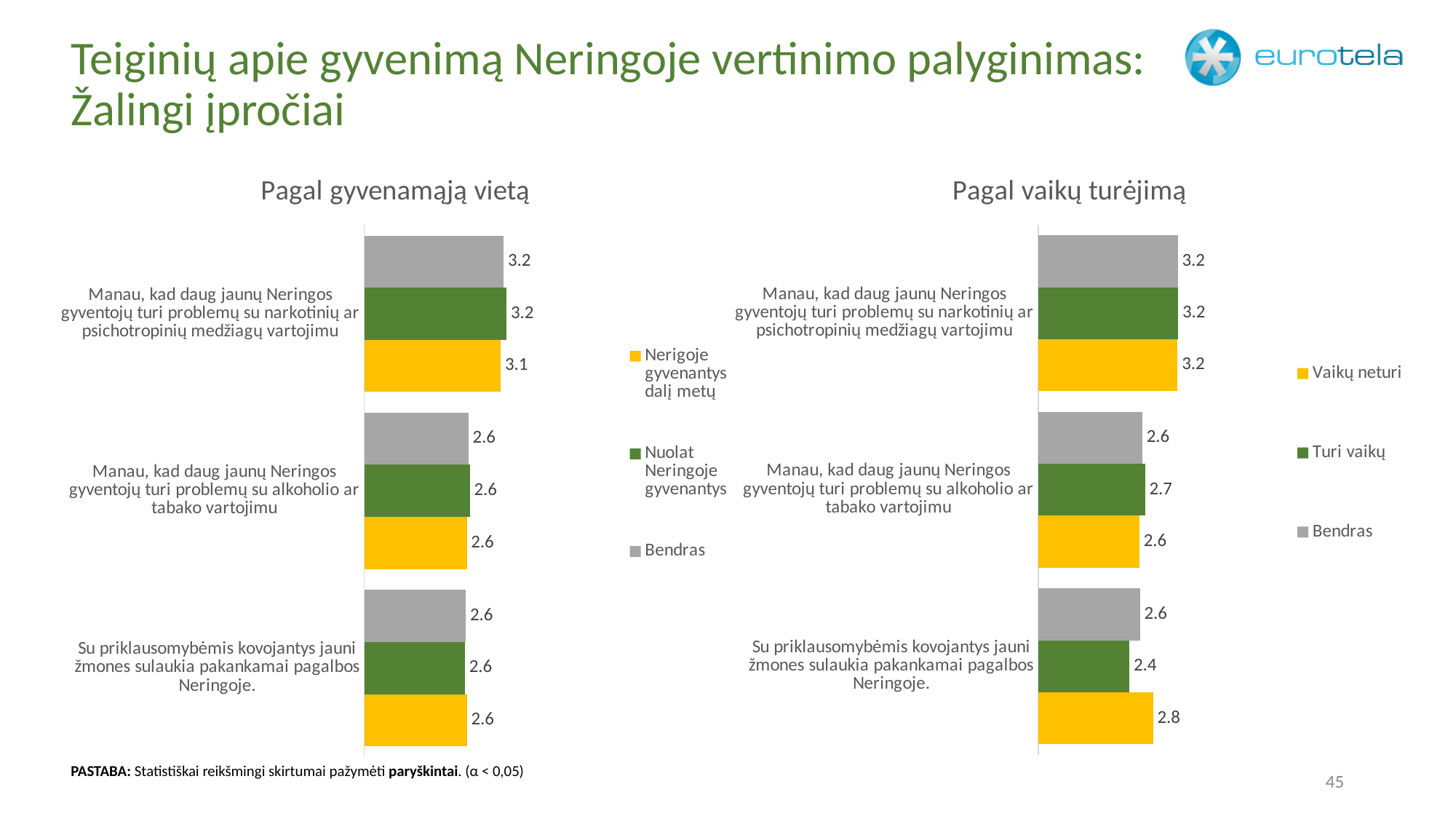
In the 'Pagal gyvenamąją vietą' chart, which is larger on the drug and psychotropic substance statement: the value for 'Nuolat Neringoje gyvenantys' or for 'Nerigoje gyvenantys dalį metų'? Nuolat Neringoje gyvenantys In the 'Pagal vaikų turėjimą' chart, what is the value for 'Turi vaikų' on the statement 'Su priklausomybėmis kovojantys jauni žmonės sulaukia pakankamai pagalbos Neringoje'? 2.4 In the 'Pagal vaikų turėjimą' chart, which series has the lowest value on the statement 'Su priklausomybėmis kovojantys jauni žmonės sulaukia pakankamai pagalbos Neringoje'? Turi vaikų In the 'Pagal vaikų turėjimą' chart, what is the value for 'Turi vaikų' on the statement about alcohol and tobacco problems (alkoholio ar tabako vartojimu)? 2.7 In the 'Pagal gyvenamąją vietą' chart, what is the value for 'Nerigoje gyvenantys dalį metų' on the statement about drug and psychotropic substance problems (narkotinių ar psichotropinių medžiagų vartojimu)? 3.1 In the 'Pagal gyvenamąją vietą' chart, what is the 'Bendras' value on the statement about alcohol and tobacco problems (alkoholio ar tabako vartojimu)? 2.6 In the 'Pagal vaikų turėjimą' chart, what is the difference between the 'Vaikų neturi' and 'Turi vaikų' values on the statement 'Su priklausomybėmis kovojantys jauni žmonės sulaukia pakankamai pagalbos Neringoje'? 0.4 What kind of chart is the 'Pagal gyvenamąją vietą' chart? Bar chart In the 'Pagal vaikų turėjimą' chart, what is the value for 'Vaikų neturi' on the statement 'Su priklausomybėmis kovojantys jauni žmonės sulaukia pakankamai pagalbos Neringoje'? 2.8 How many statements (categories) are shown in the 'Pagal gyvenamąją vietą' chart? 3 How many series does the legend of the 'Pagal vaikų turėjimą' chart list? 3 In the 'Pagal vaikų turėjimą' chart, which series has the highest value on the statement 'Su priklausomybėmis kovojantys jauni žmonės sulaukia pakankamai pagalbos Neringoje'? Vaikų neturi